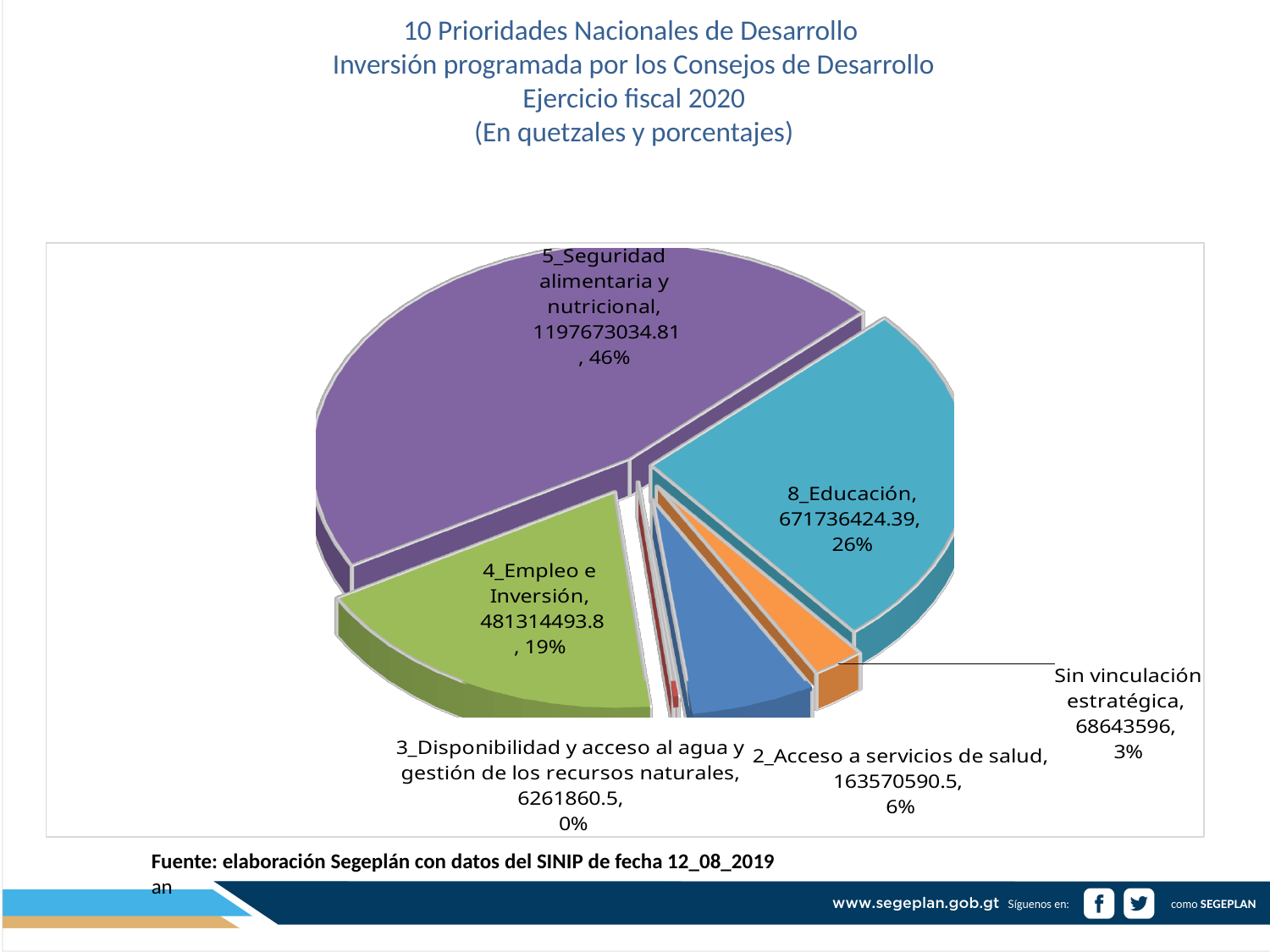
What is the value shown for 3_Disponibilidad y acceso al agua y gestión de los recursos naturales? 6261860.5 What is the difference in percentage share between 5_Seguridad alimentaria y nutricional and 8_Educación? 20% How many slices does the pie chart have? 6 What percentage share does 4_Empleo e Inversión have? 19% What is the value shown for 2_Acceso a servicios de salud? 163570590.5 What kind of chart is shown on the slide? Pie chart Which fiscal year does the chart title refer to? 2020 Which category has the smallest slice of the pie? 3_Disponibilidad y acceso al agua y gestión de los recursos naturales What percentage share does Sin vinculación estratégica have? 3% What is the programmed investment value for 8_Educación? 671736424.39 Which category has the largest slice of the pie? 5_Seguridad alimentaria y nutricional Which is larger, the value for 8_Educación or the value for 4_Empleo e Inversión? 8_Educación